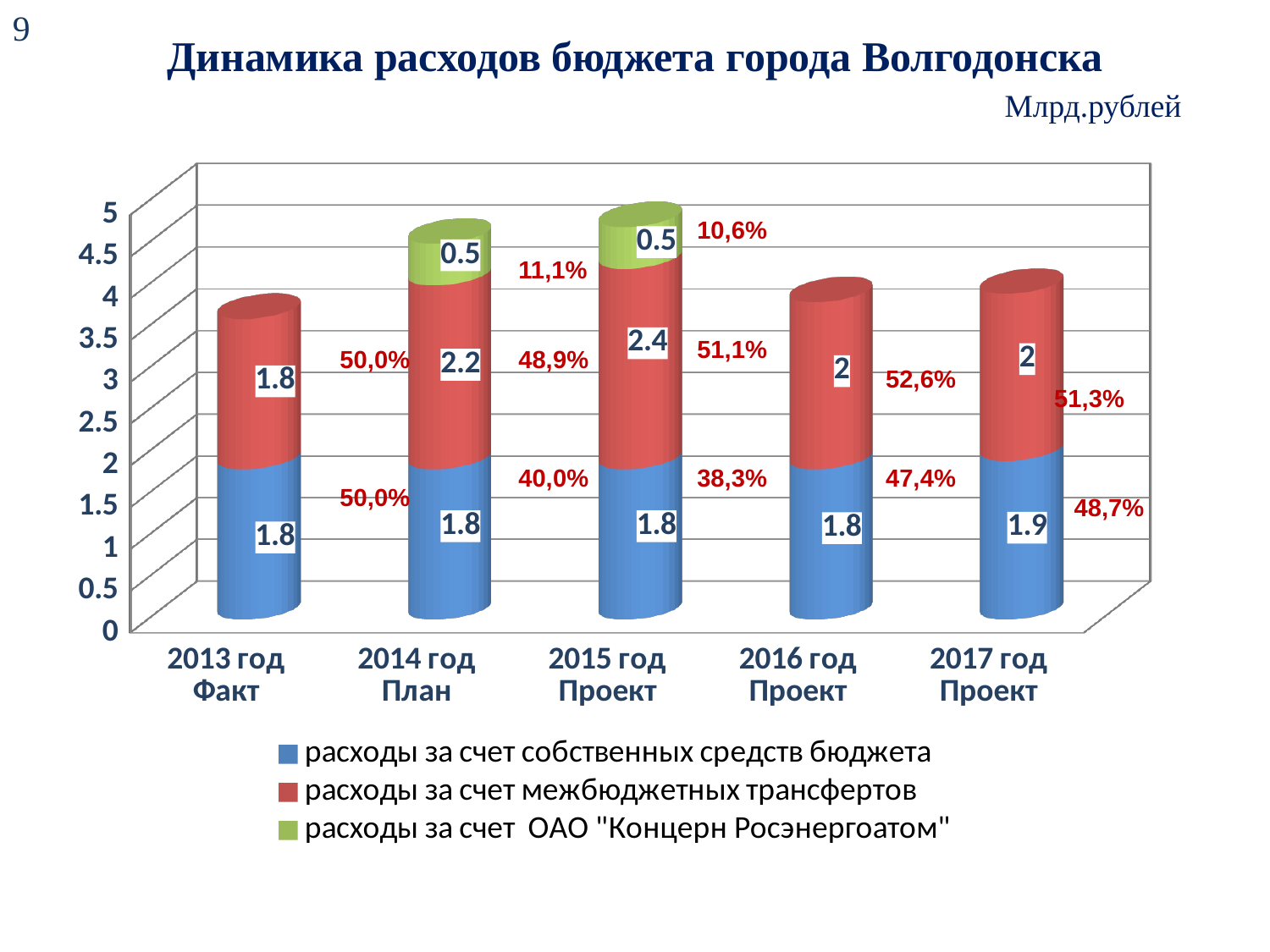
What is the total of the stacked bar for 2015 год Проект? 4.7 Which year has the highest value for расходы за счет межбюджетных трансфертов? 2015 год Проект How many series does the legend list? 3 What type of chart is shown on the slide? Stacked bar chart Which is larger: расходы за счет межбюджетных трансфертов in 2014 год План or in 2016 год Проект? 2014 год План What is the value of расходы за счет ОАО "Концерн Росэнергоатом" for 2014 год План? 0.5 What is the value of расходы за счет межбюджетных трансфертов for 2015 год Проект? 2.4 What is the value of расходы за счет собственных средств бюджета for 2017 год Проект? 1.9 What is the total of the stacked bar for 2013 год Факт? 3.6 What is the difference between расходы за счет межбюджетных трансфертов in 2015 год Проект and 2013 год Факт? 0.6 What percentage share is shown for расходы за счет межбюджетных трансфертов in 2016 год Проект? 52,6% How many categories (years) are shown on the x axis? 5